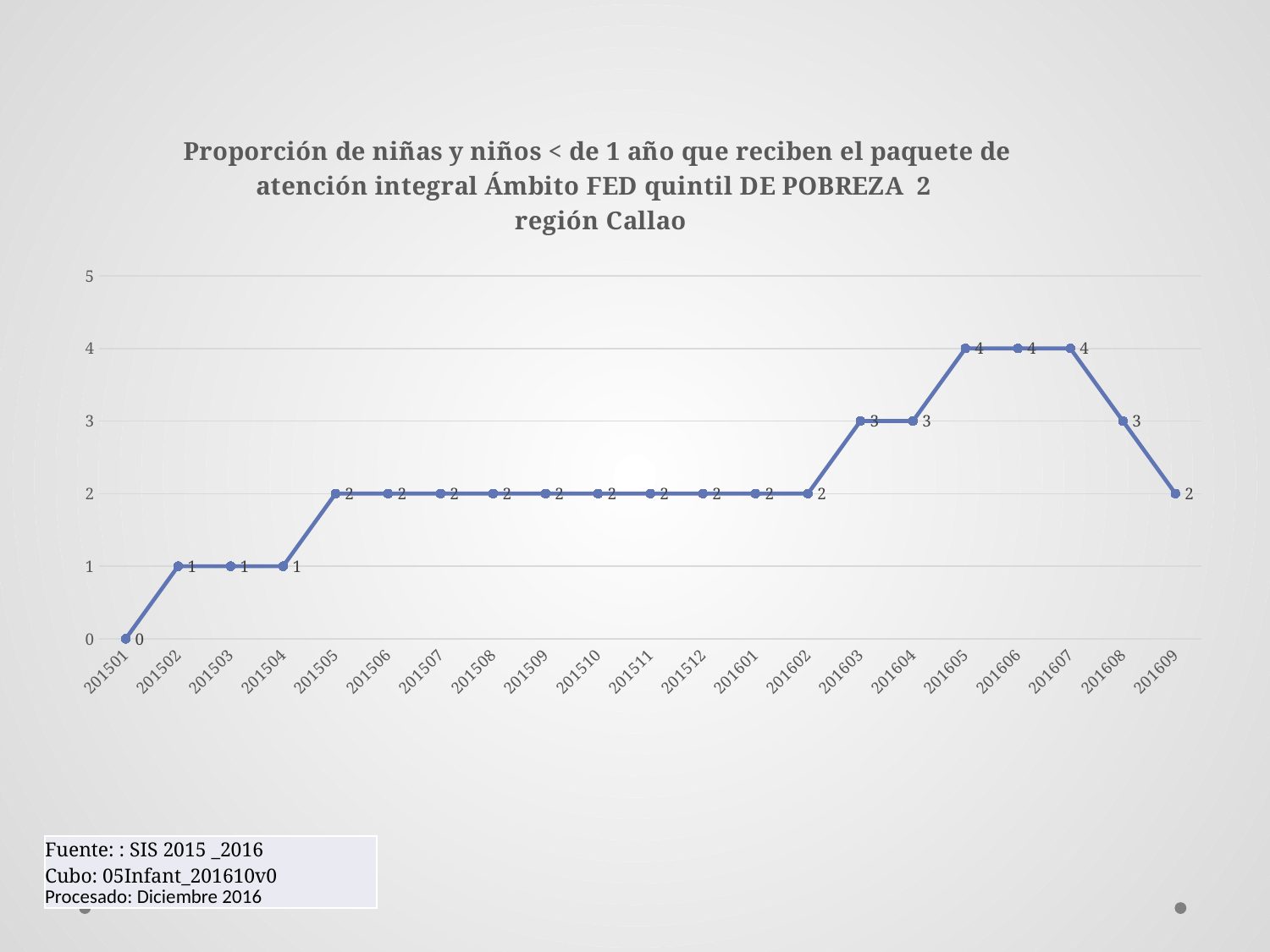
How many data points are plotted on the chart? 21 What is the highest value plotted on the chart? 4 What is the value for 201603? 3 What kind of chart is shown on the slide? line chart Does the value rise or fall from 201607 to 201609? fall What is the value for 201605? 4 Which region is named in the chart title? Callao What is the value for 201609? 2 Which is larger, the value for 201504 or the value for 201604? 201604 What is the value for 201501? 0 What is the difference between the values for 201607 and 201608? 1 Which period has the lowest value? 201501